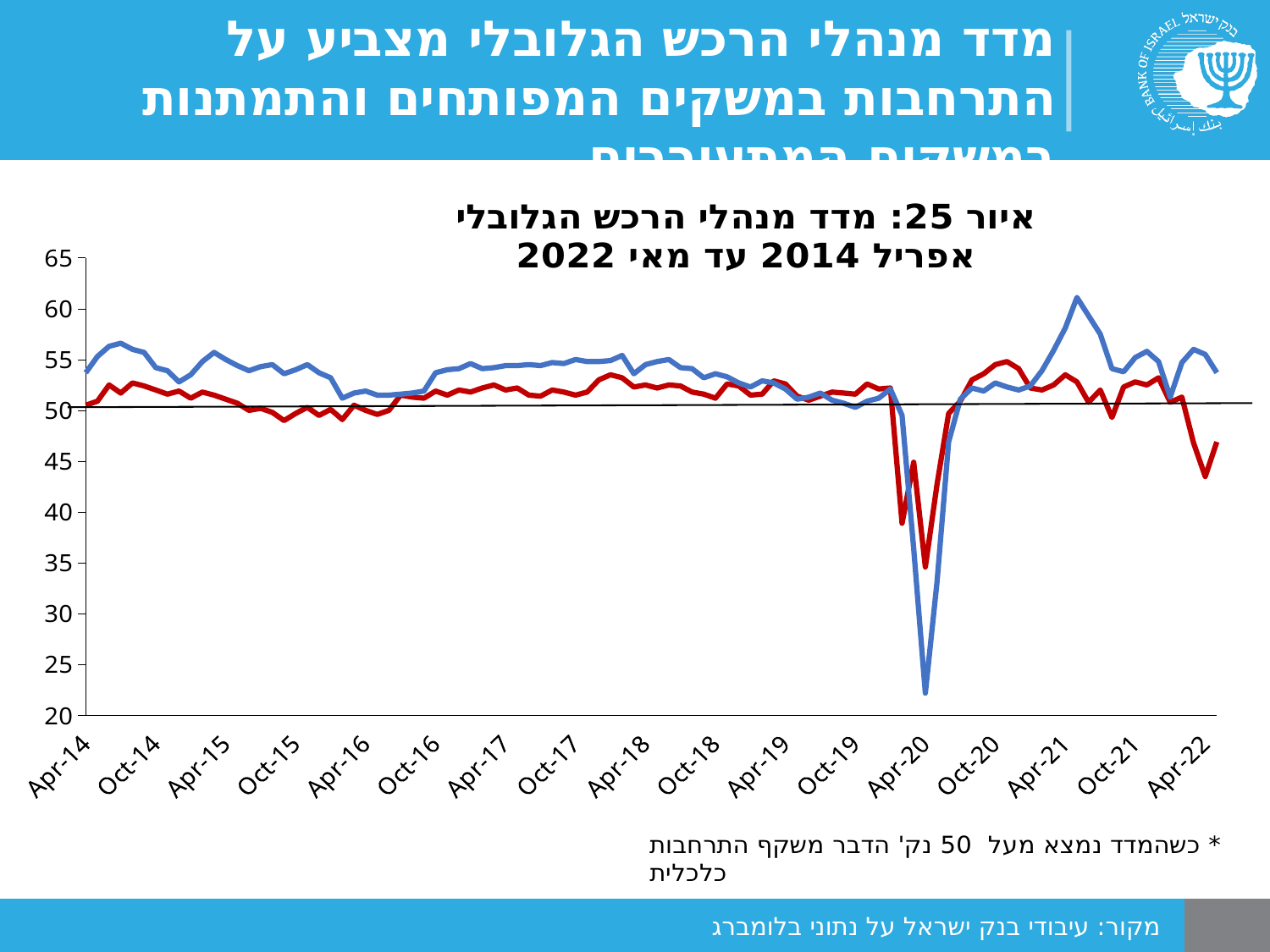
What value does the horizontal reference line on the chart mark? 50 Between Oct-19 and Apr-20, does the blue line rise or fall? fall Which line, blue or red, reaches the highest value on the chart? blue How many date labels are shown on the x axis? 17 How many lines (series) are plotted on the chart? 2 Is the peak of the blue line around Apr-21 greater or less than 55? greater Which line, blue or red, reaches the lowest value on the chart? blue Is the lowest value of the blue line greater or less than 25? less At Apr-14, which line has the higher value, blue or red? blue What is the figure number given in the chart title? 25 Is the lowest value of the red line greater or less than 40? less What kind of chart is shown on the slide? line chart